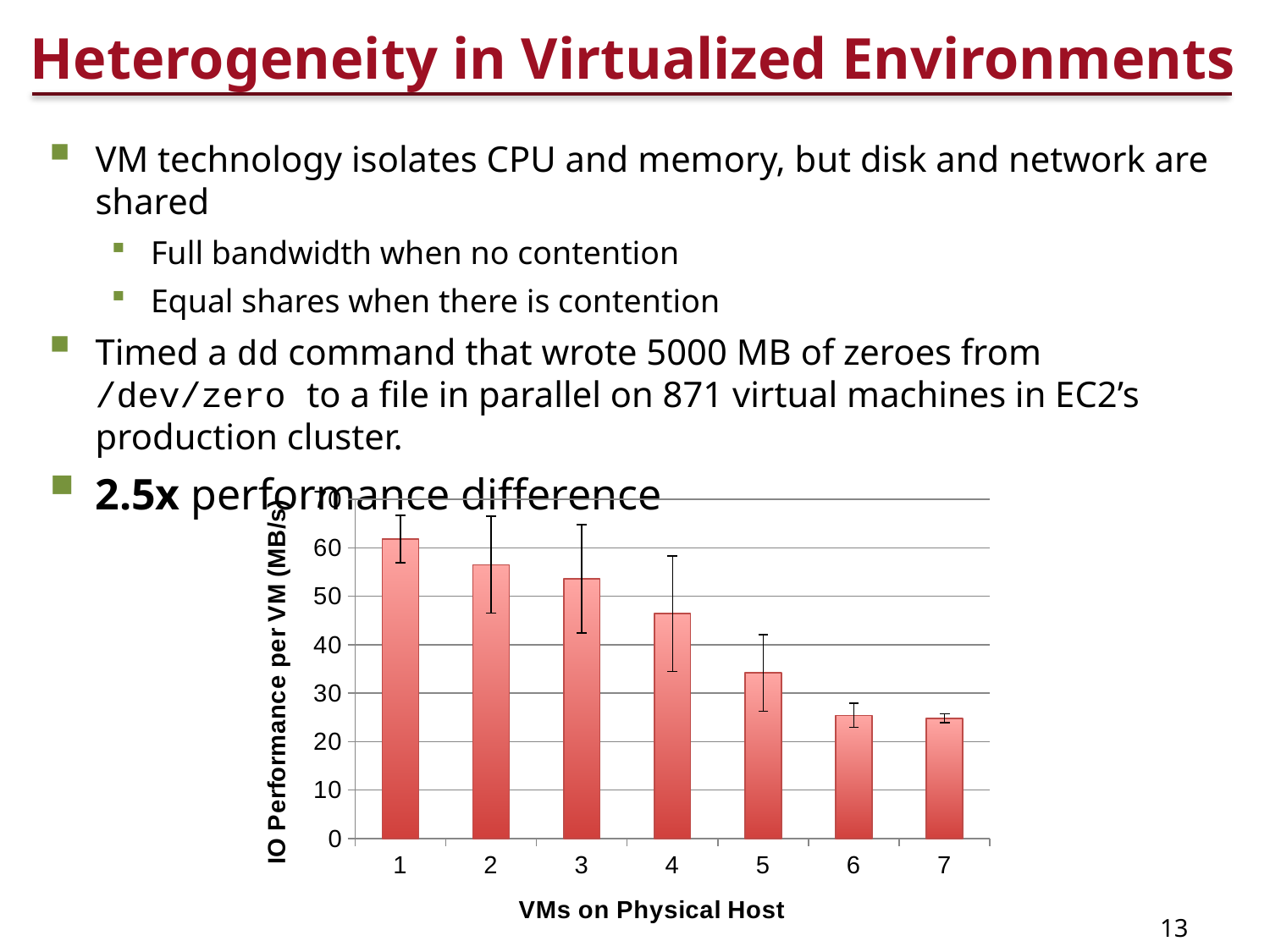
Is the IO Performance per VM for 4 VMs on Physical Host greater or less than 50? less What kind of chart is shown on the slide? bar chart What is the title of the x axis of the chart? VMs on Physical Host Is the IO Performance per VM for 7 VMs on Physical Host greater or less than 30? less How many categories are shown on the x axis of the chart? 7 Is the IO Performance per VM for 1 VM on Physical Host greater or less than 60? greater Which has a higher IO Performance per VM: 2 VMs or 5 VMs on Physical Host? 2 VMs Do the bar values rise or fall as the number of VMs on Physical Host increases? fall Which number of VMs on Physical Host has the highest IO Performance per VM? 1 What is the title of the y axis of the chart? IO Performance per VM (MB/s) Which has a lower IO Performance per VM: 3 VMs or 6 VMs on Physical Host? 6 VMs